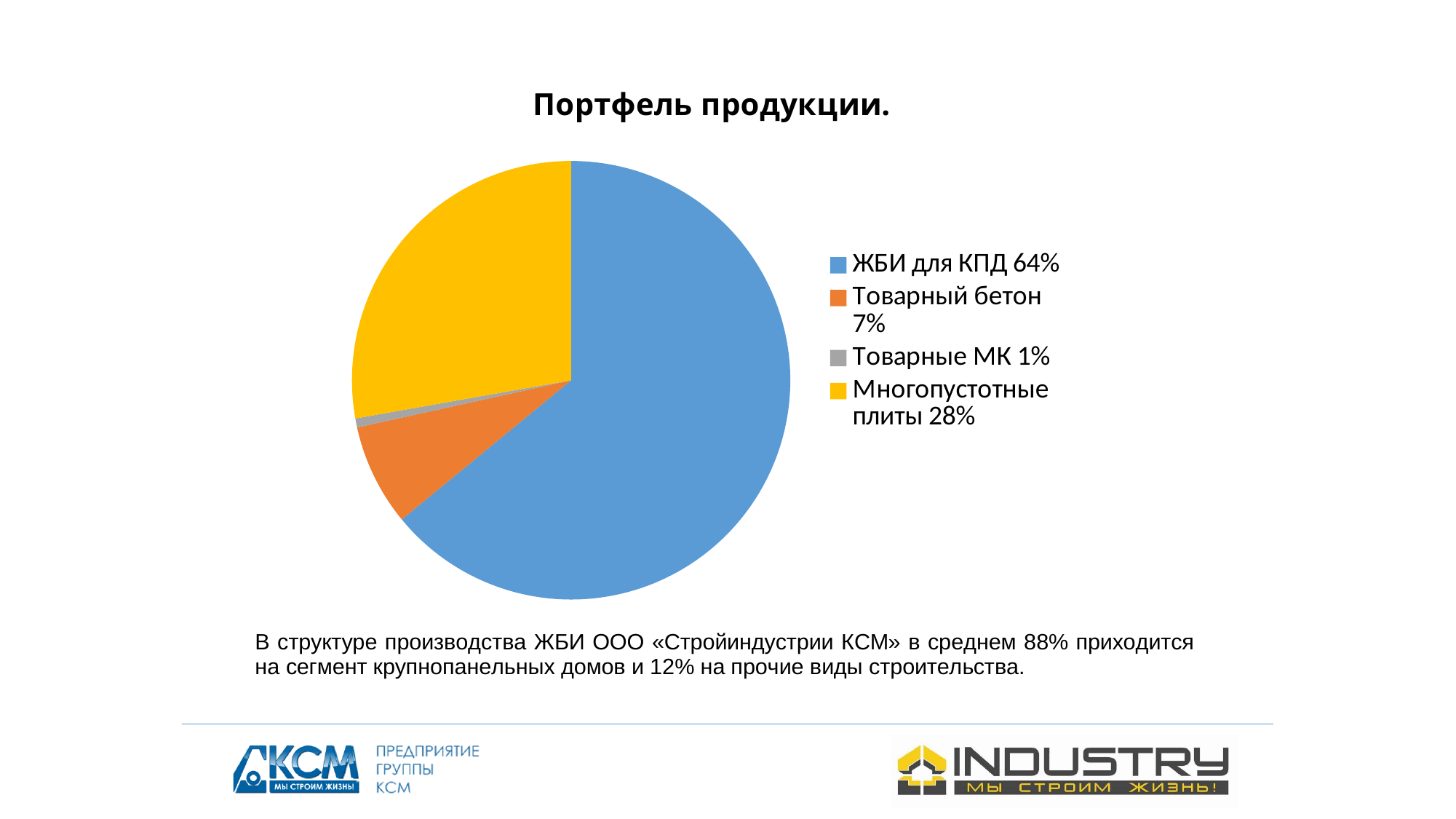
What is the title of the chart? Портфель продукции. What share of the pie is Товарный бетон? 7% Which category has the largest share of the pie? ЖБИ для КПД How many slices does the pie chart have? 4 What share of the pie is Товарные МК? 1% Which category has the smallest share of the pie? Товарные МК What colour is the slice for Многопустотные плиты? yellow Which is larger, the share for Товарный бетон or the share for Многопустотные плиты? Многопустотные плиты What share of the pie is Многопустотные плиты? 28% What is the difference in percentage points between ЖБИ для КПД and Многопустотные плиты? 36 What kind of chart is shown on the slide? pie chart